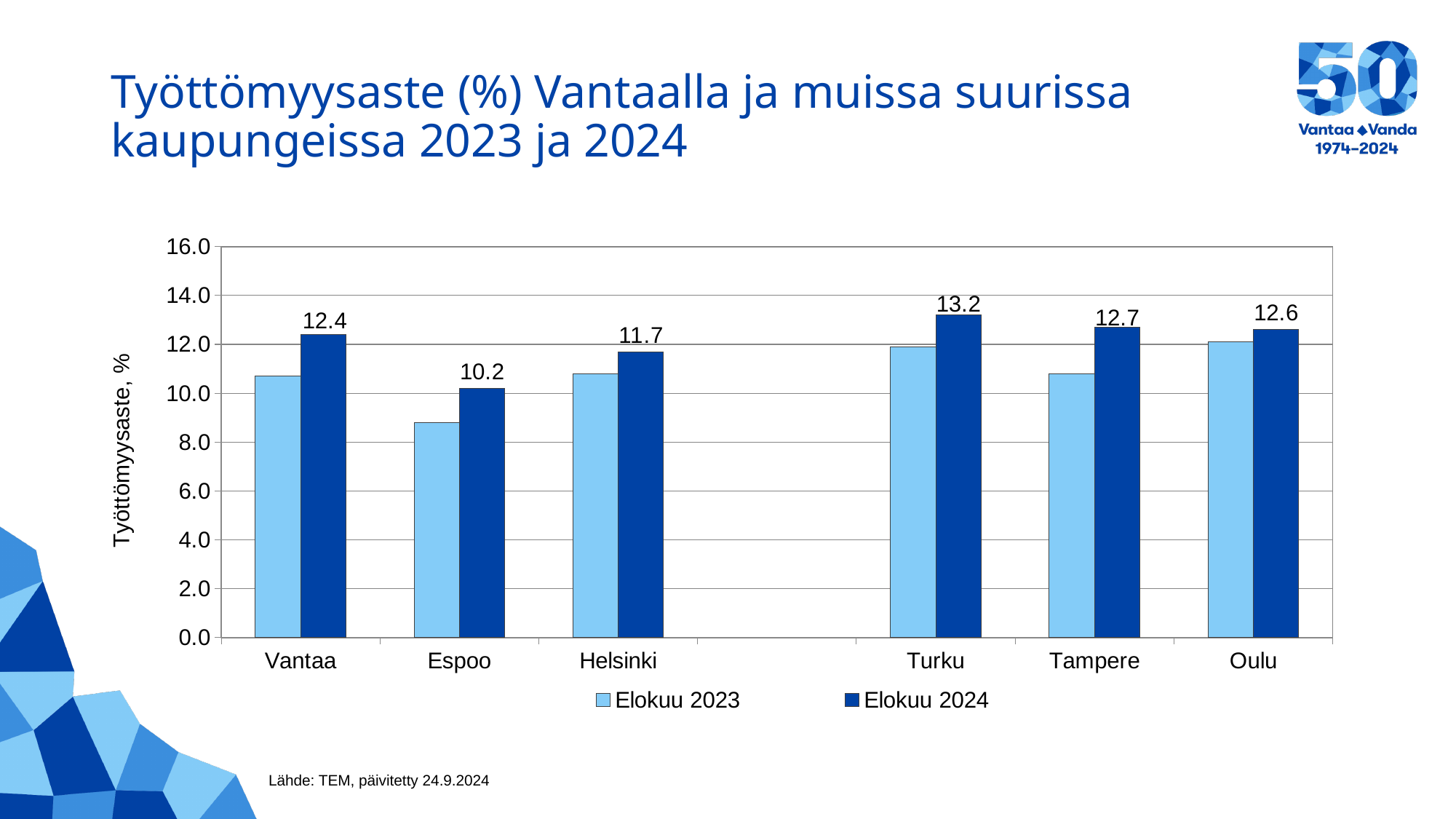
What is the difference between the Elokuu 2024 unemployment rates of Turku and Espoo? 3.0 How many series does the legend list? 2 Is the Elokuu 2023 unemployment rate for Turku greater or less than 10.0? greater What is the unemployment rate for Vantaa in Elokuu 2024? 12.4 What kind of chart is shown on the slide? Bar chart Which city has the lowest unemployment rate in Elokuu 2024? Espoo How many cities are shown on the x axis of the chart? 6 Which is larger, the Elokuu 2024 unemployment rate for Tampere or for Vantaa? Tampere What is the unemployment rate for Turku in Elokuu 2024? 13.2 What is the unemployment rate for Espoo in Elokuu 2024? 10.2 Is the Elokuu 2023 unemployment rate for Espoo greater or less than 10.0? less Which city has the highest unemployment rate in Elokuu 2024? Turku